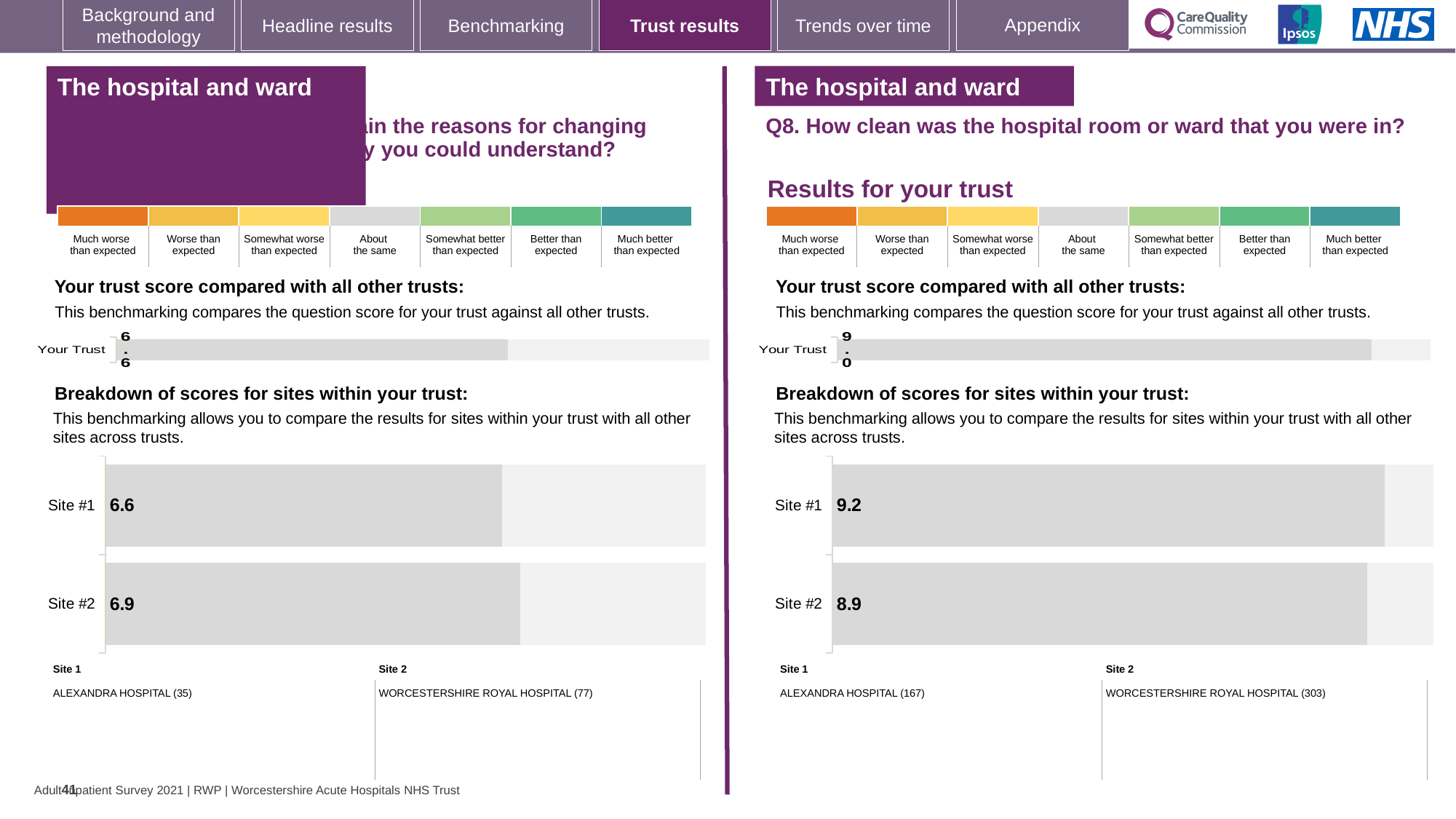
On the left-hand slide, what is the score for Site #1 in the breakdown of scores for sites within your trust? 6.6 On the left-hand slide, what is the 'Your Trust' score in the chart comparing your trust with all other trusts? 6.6 On the right-hand slide (Q8), which site has the higher score in the breakdown of scores for sites within your trust? Site #1 On the right-hand slide (Q8), what is the score for Site #2 in the breakdown of scores for sites within your trust? 8.9 On the right-hand slide (Q8. How clean was the hospital room or ward that you were in?), what is the score for Site #1 in the breakdown of scores for sites within your trust? 9.2 On the right-hand slide (Q8), what is the 'Your Trust' score in the chart comparing your trust with all other trusts? 9.0 On the right-hand slide (Q8), what is the difference between the Site #1 and Site #2 scores? 0.3 On the left-hand slide, which site has the lower score in the breakdown of scores for sites within your trust? Site #1 On the left-hand slide, what is the difference between the Site #2 and Site #1 scores? 0.3 On the left-hand slide, what is the score for Site #2 in the breakdown of scores for sites within your trust? 6.9 What type of chart is used for the breakdown of scores for sites within your trust on the left-hand slide? Bar chart How many sites are shown in the breakdown of scores chart on the right-hand slide (Q8)? 2